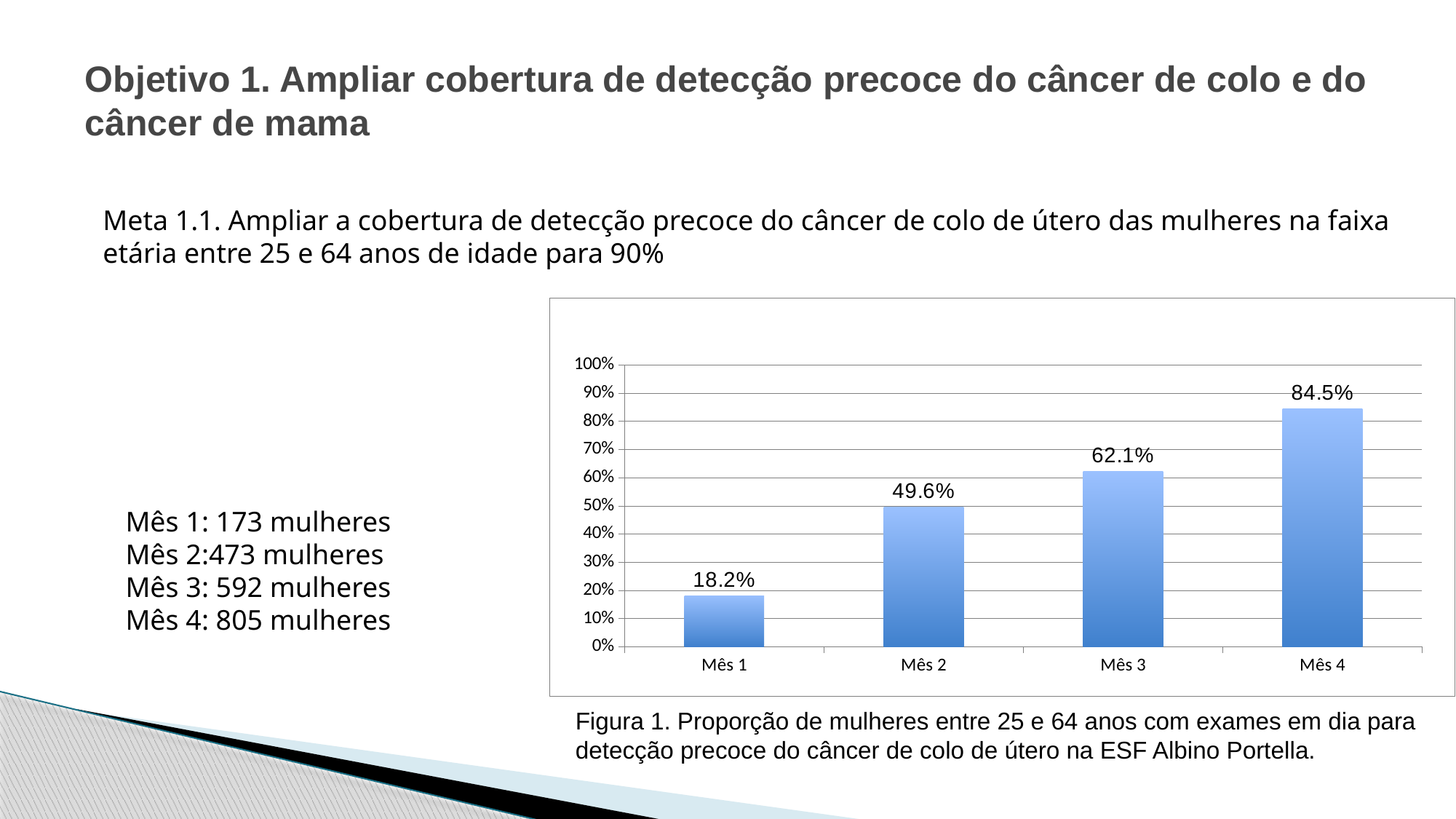
Do the values rise or fall from Mês 1 to Mês 4? rise Which month has the highest value? Mês 4 Which is larger, the value for Mês 2 or the value for Mês 3? Mês 3 Which month has the lowest value? Mês 1 What is the difference between the values for Mês 3 and Mês 2? 12.5% What kind of chart is shown? bar chart How many months are shown on the x axis? 4 Is the value for Mês 2 greater or less than 40%? greater What is the value for Mês 1? 18.2% What is the value for Mês 4? 84.5% What is the difference between the values for Mês 4 and Mês 1? 66.3% What is the value for Mês 3? 62.1%